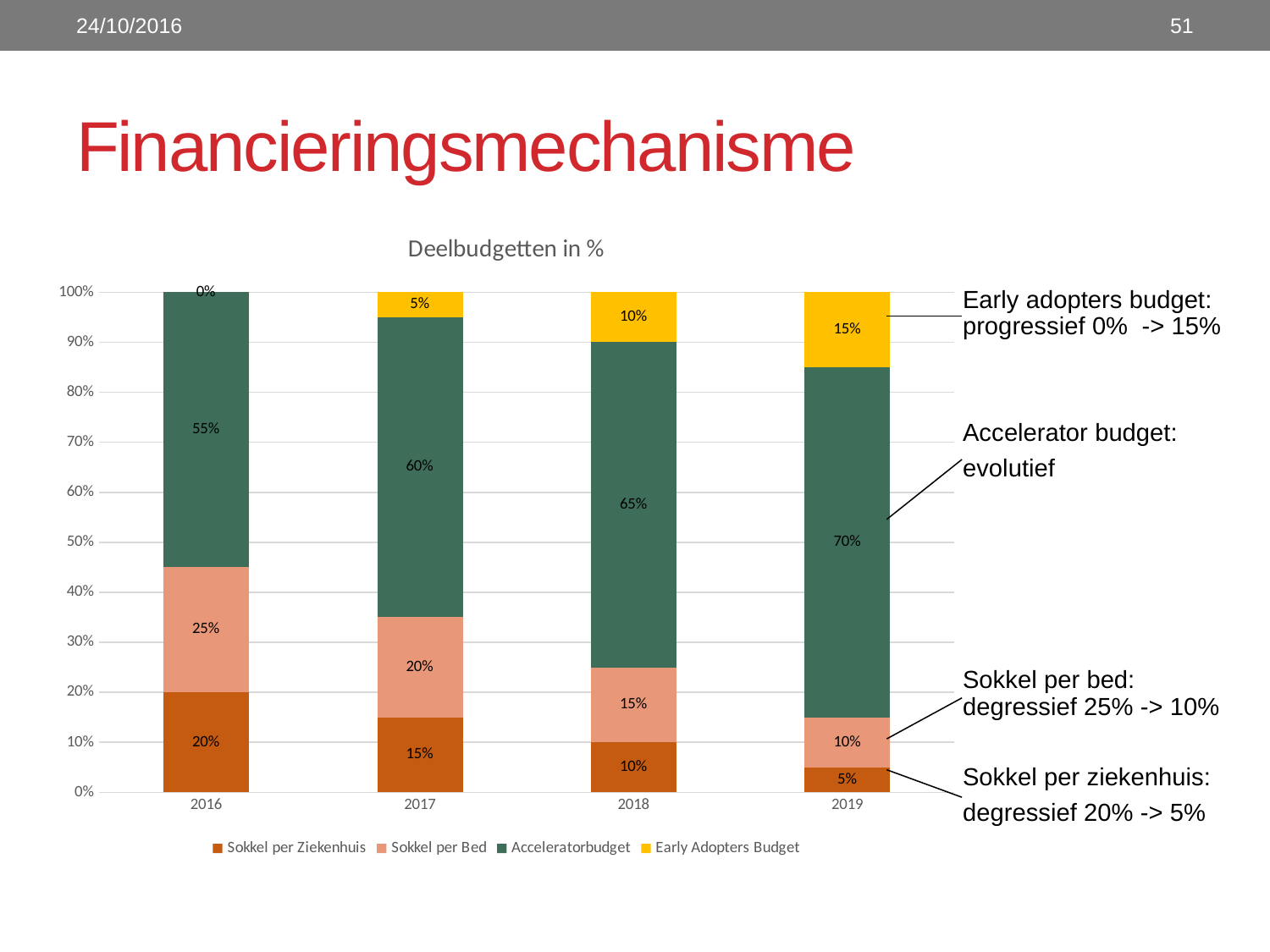
In which year is the Early Adopters Budget value lowest? 2016 Which is larger in 2017: Sokkel per Bed or Early Adopters Budget? Sokkel per Bed What is the title of the chart? Deelbudgetten in % How many series does the legend list? 4 In which year is the Sokkel per Bed value highest? 2016 What is the value for Sokkel per Ziekenhuis in 2017? 15% What is the value for Early Adopters Budget in 2019? 15% What kind of chart is shown on the slide? Stacked bar chart What is the value for Acceleratorbudget in 2018? 65% What is the difference between the Acceleratorbudget values for 2019 and 2016? 15% Does the Sokkel per Ziekenhuis value rise or fall from 2016 to 2019? Fall How many years are shown on the x axis? 4